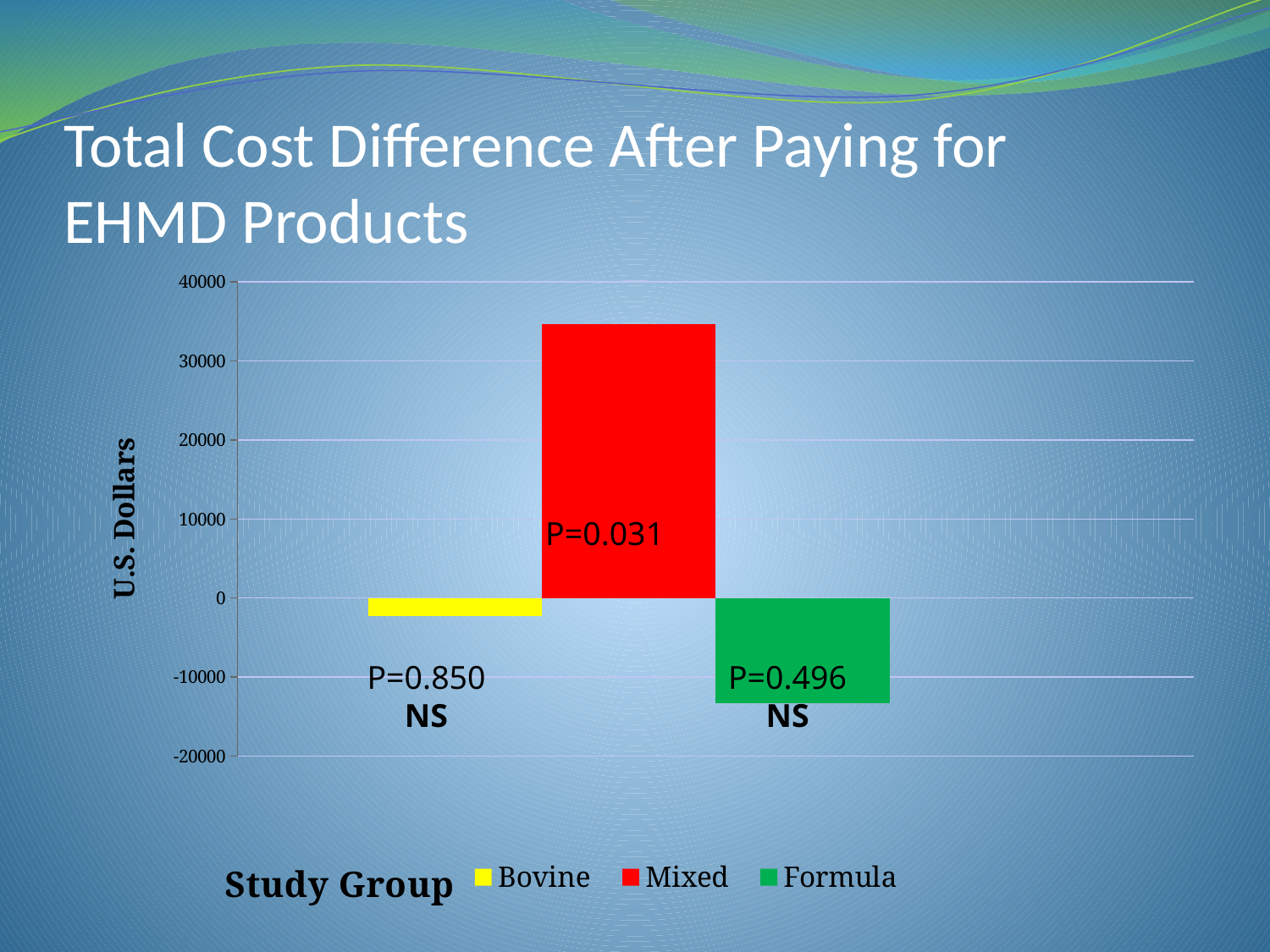
Is the value for Formula greater or less than -10000? less Which is larger, the value for Bovine or the value for Formula? Bovine What kind of chart is shown on the slide? bar chart Is the value for Bovine greater or less than -10000? greater Which is larger, the value for Mixed or the value for Bovine? Mixed How many series does the legend list? 3 Which study group has the highest total cost difference? Mixed Which study group has the lowest total cost difference? Formula What is the label on the vertical axis? U.S. Dollars Is the value for Mixed greater or less than 30000? greater What P-value is shown for the Mixed group? P=0.031